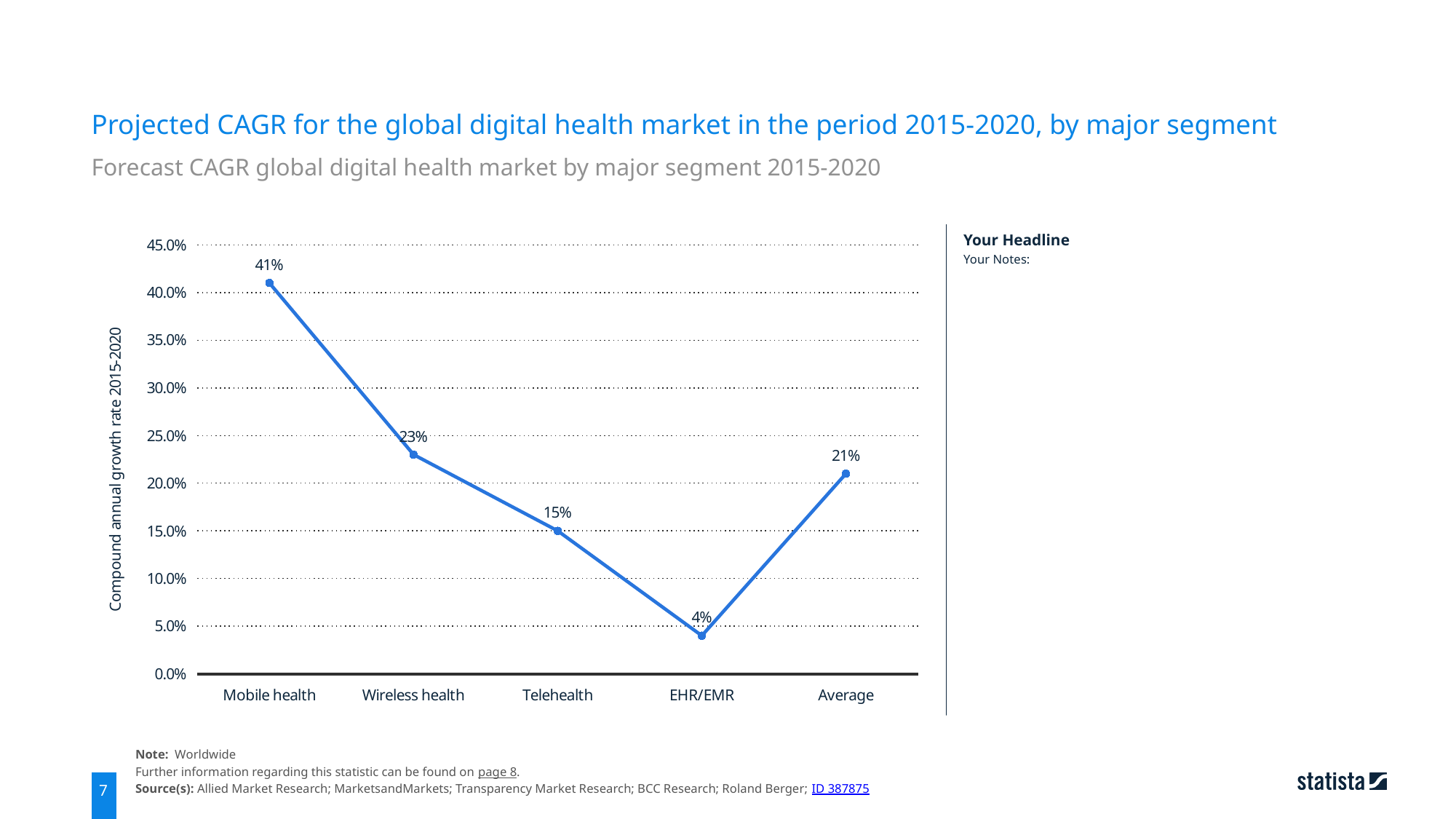
Which has a higher projected CAGR, Telehealth or Wireless health? Wireless health What is the projected CAGR for Telehealth? 15% What is the Average projected CAGR shown on the chart? 21% Which segment has the lowest projected CAGR? EHR/EMR How many categories are plotted on the x axis? 5 Which segment has the highest projected CAGR? Mobile health What kind of chart is shown on the slide? Line chart What is the projected CAGR for Wireless health? 23% What is the difference between the projected CAGR for Mobile health and Wireless health? 18% What is the label of the y axis? Compound annual growth rate 2015-2020 What is the projected CAGR for Mobile health? 41% What is the projected CAGR for EHR/EMR? 4%